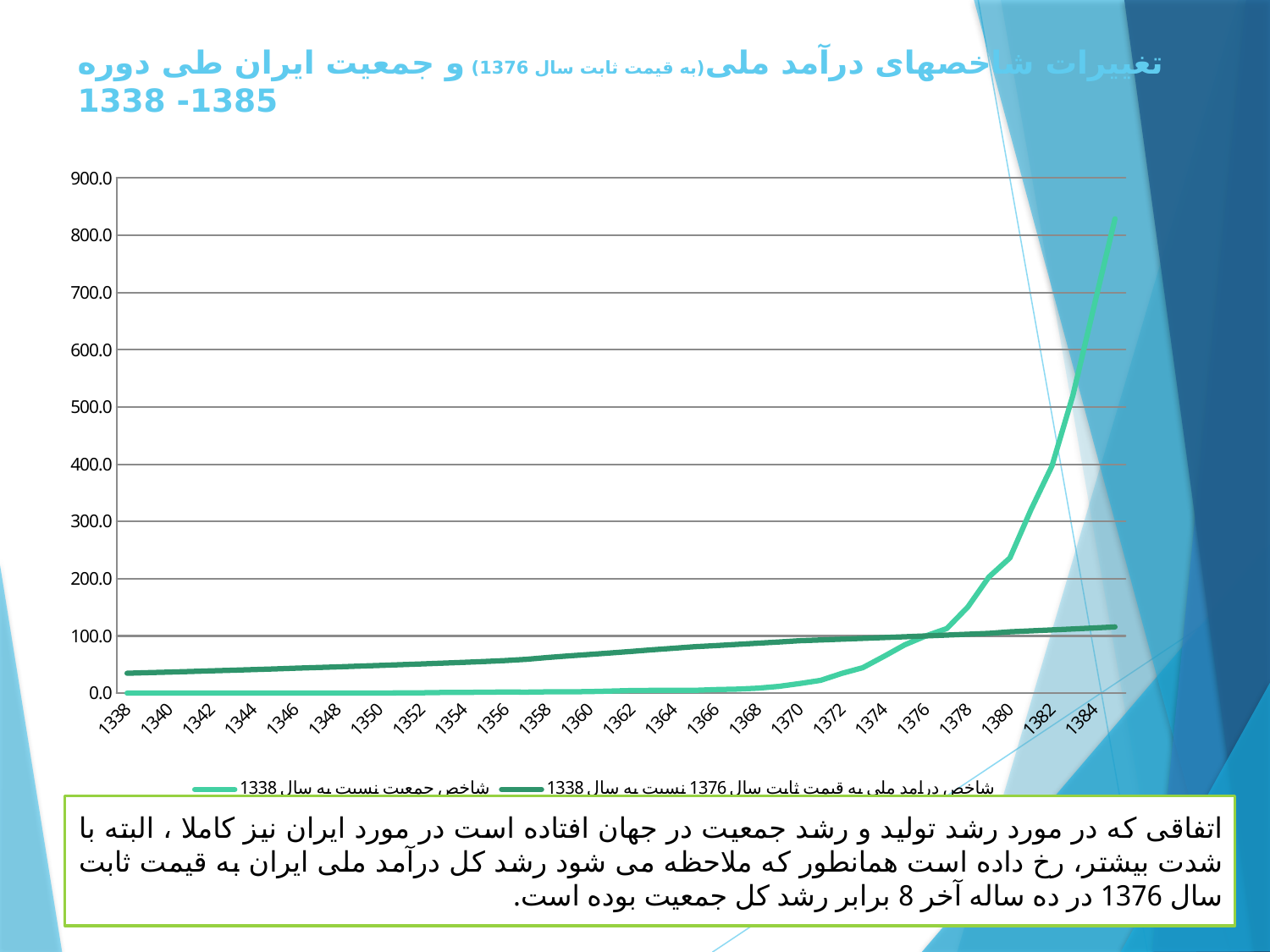
At 1384, which series has the higher value: the national income index or the population index? national income index Is the value of the population index series at 1338 greater or less than 100? less How many series does the chart's legend list? 2 Is the value of the population index series at 1384 greater or less than 100? greater What is the highest value shown on the chart's y axis? 900.0 Does the population index series (شاخص جمعیت) rise or fall along the x axis from 1338 to 1385? rise At 1360, which series has the higher value: the national income index or the population index? population index Is the value of the national income index series at 1380 greater or less than 200? greater What kind of chart is shown on the slide? line chart Does the national income index series (شاخص درآمد ملی) rise or fall along the x axis from 1338 to 1385? rise